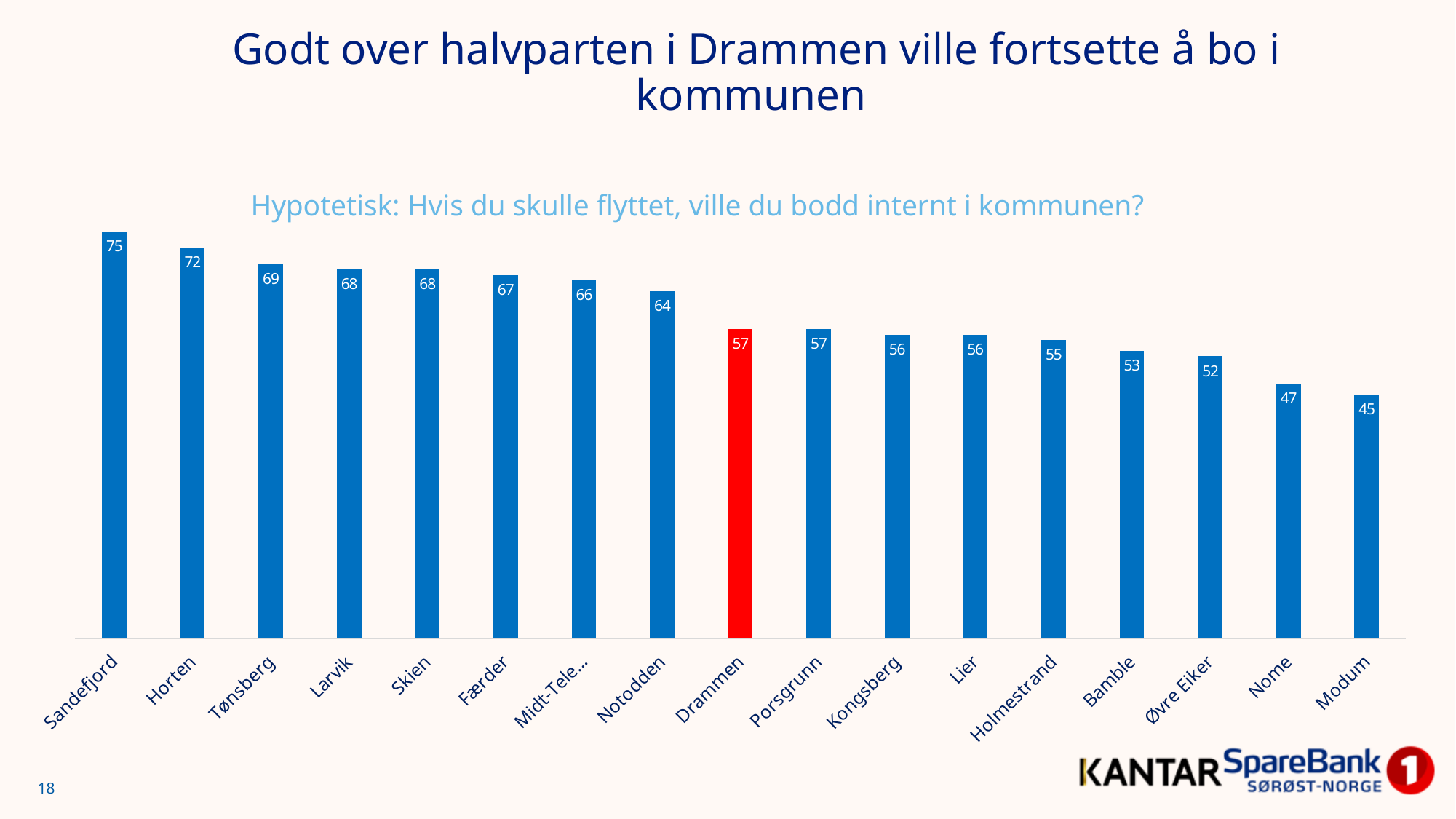
What kind of chart is shown on the slide? Bar chart How many municipalities are shown in the chart? 17 What is the value for Drammen? 57 What is the difference between the values for Horten and Nome? 25 What is the value for Holmestrand? 55 Which municipality has the highest value? Sandefjord Which municipality has the lowest value? Modum What is the value for Modum? 45 What is the difference between the values for Sandefjord and Drammen? 18 Which bar is highlighted in red? Drammen What is the value for Sandefjord? 75 Which is larger, the value for Notodden or the value for Bamble? Notodden